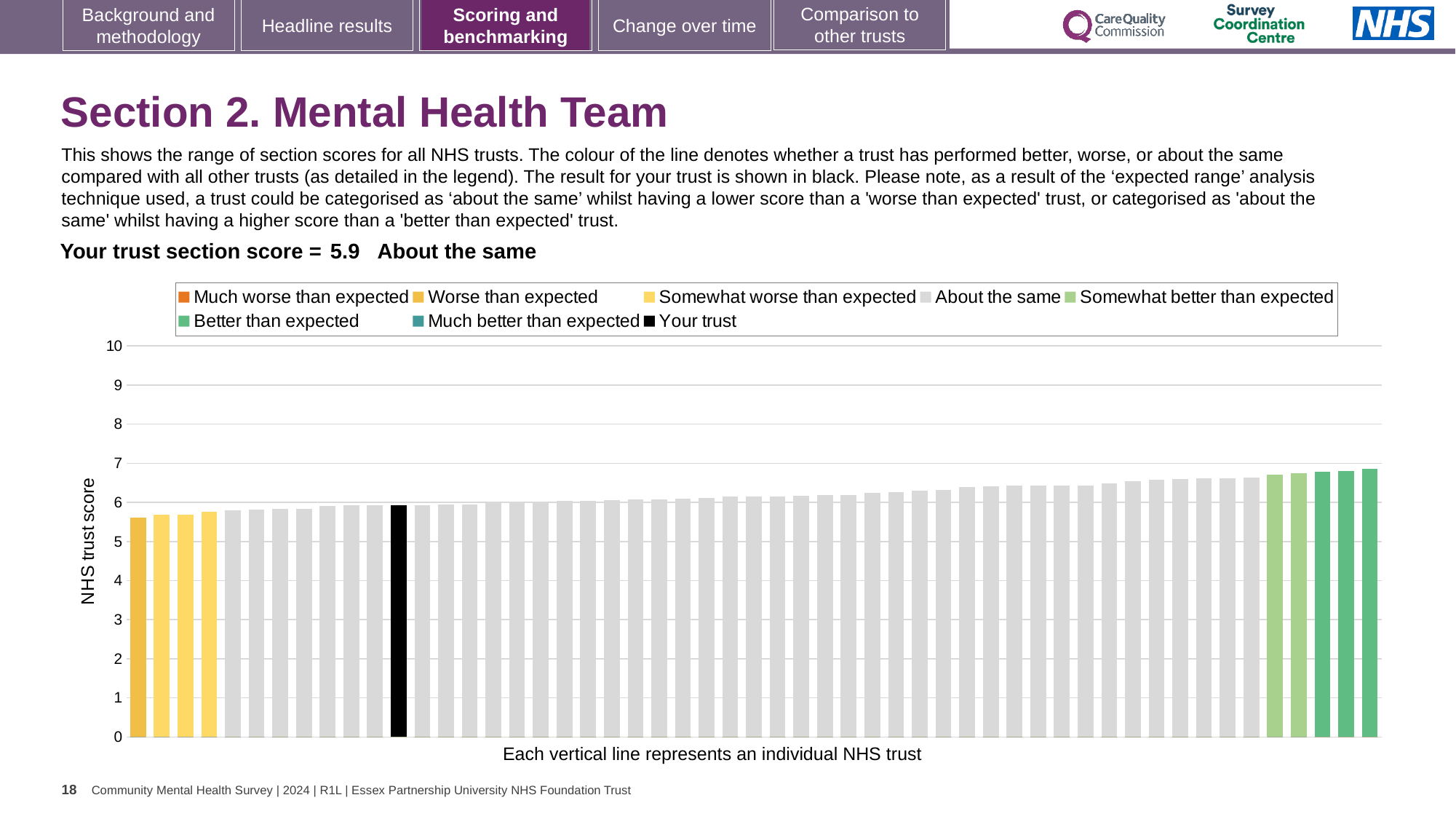
Do the bar values rise or fall moving from left to right along the x axis? Rise What kind of chart is shown on the slide? Bar chart Is the value of the highest bar in the chart greater or less than 7? less How many entries does the chart legend list? 8 How many bars are coloured as 'Somewhat worse than expected' (light yellow)? 3 What is the section score for your trust shown on the slide? 5.9 Which is larger: the bar for your trust or the leftmost bar in the chart? Your trust What is the label on the vertical axis of the chart? NHS trust score How many bars are coloured as 'Better than expected' (dark green)? 3 Is the value of the lowest bar in the chart greater or less than 5? greater What colour is the bar representing your trust? Black Which performance category is your trust placed in for this section? About the same